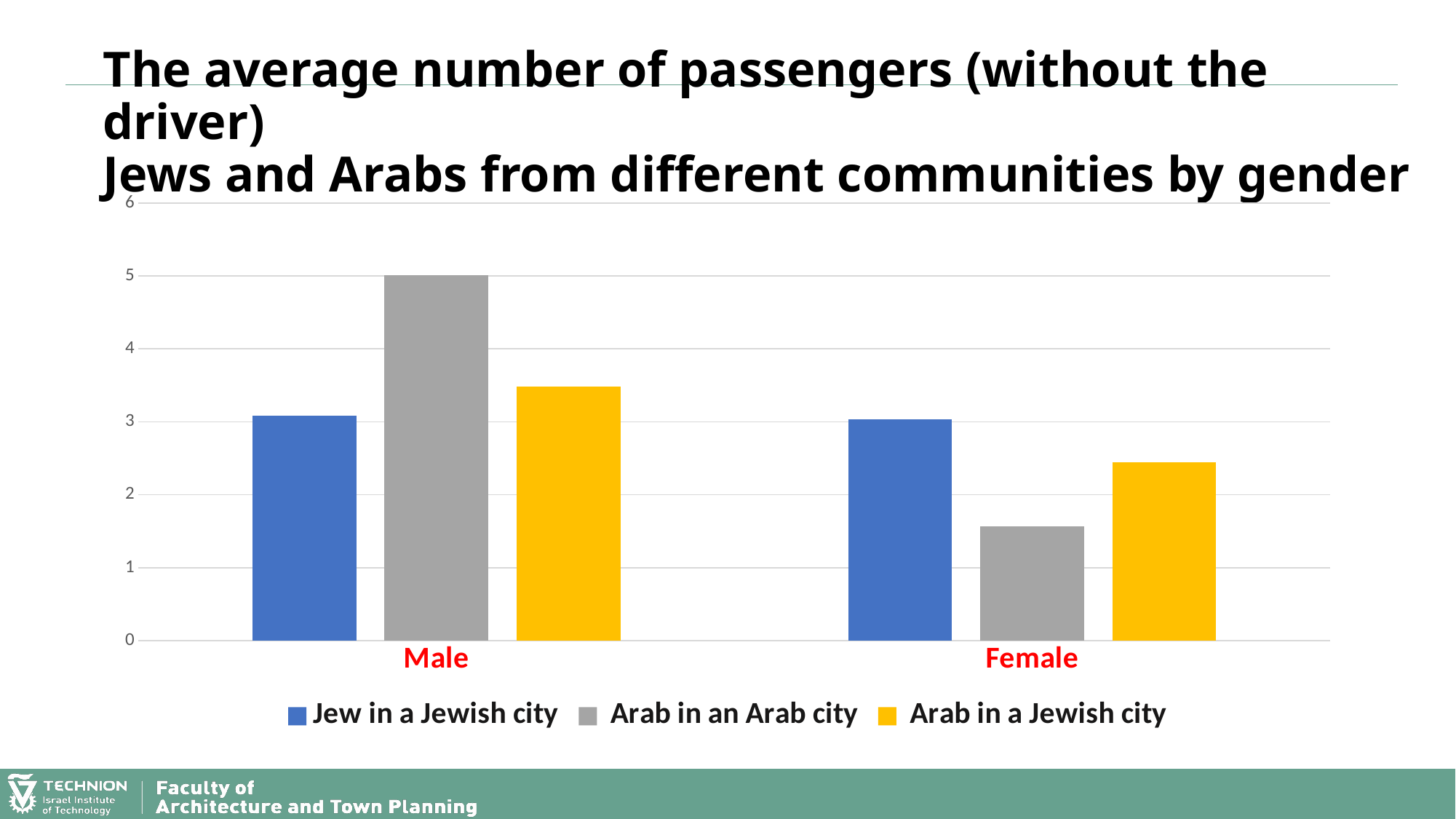
How many categories are shown on the x axis? 2 Which series has the highest value for Male? Arab in an Arab city Which series has the lowest value for Male? Jew in a Jewish city How many series does the legend list? 3 What kind of chart is shown on the slide? bar chart Which series has the highest value for Female? Jew in a Jewish city Which series has the lowest value for Female? Arab in an Arab city Is the value for Arab in an Arab city for Female greater or less than 2? less Is the value for Arab in a Jewish city for Female greater or less than 2? greater Is the value for Arab in a Jewish city for Male greater or less than 4? less What colour represents Arab in a Jewish city in the legend? yellow For Arab in an Arab city, is the value larger for Male or Female? Male